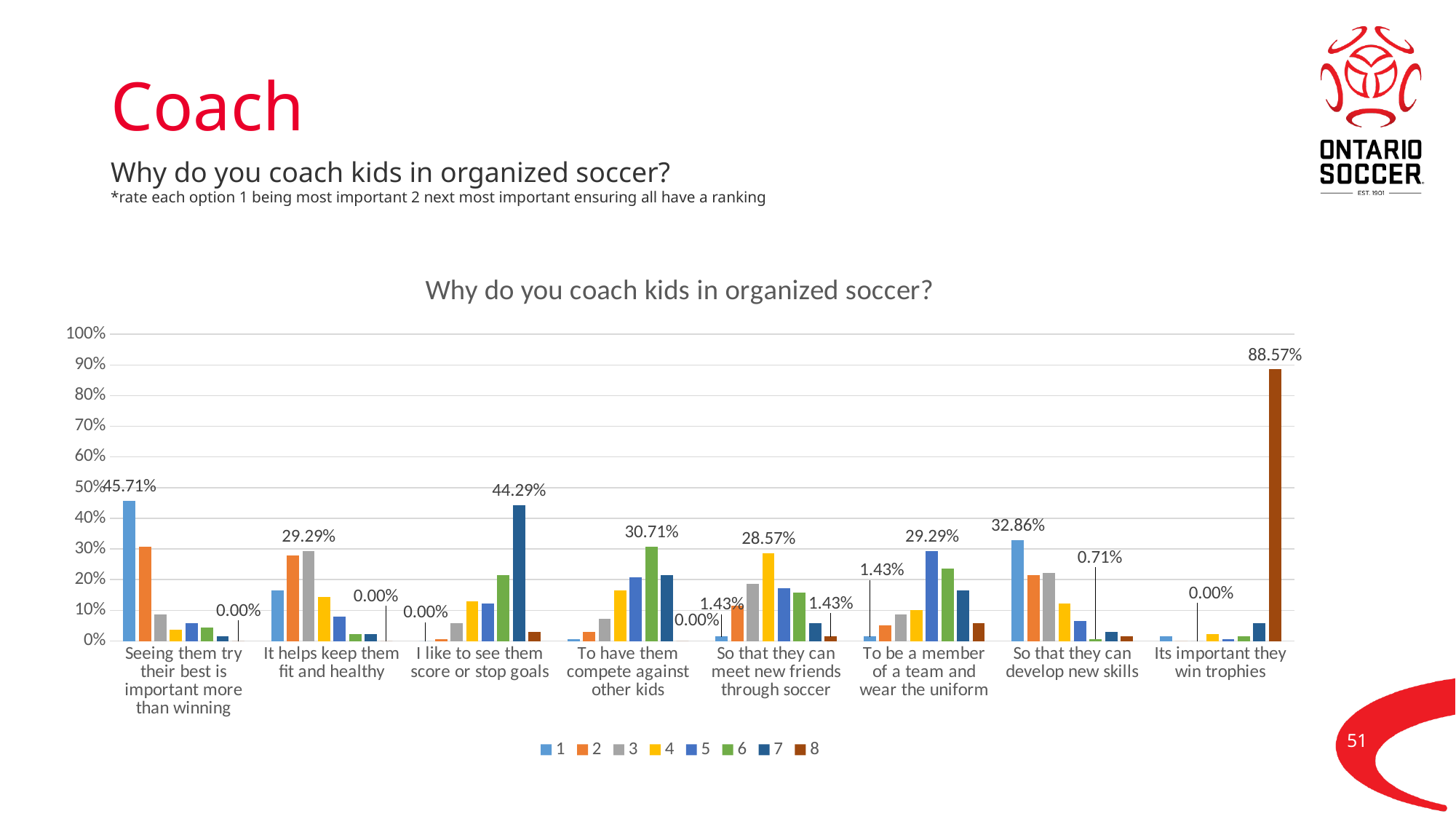
How many series does the legend list? 8 What is the value for series 6 in the category 'To have them compete against other kids'? 30.71% What is the value for series 7 in the category 'I like to see them score or stop goals'? 44.29% What is the difference between the series 8 value for 'Its important they win trophies' and the series 1 value for 'Seeing them try their best is important more than winning'? 42.86% What kind of chart is shown on the slide? bar chart What is the value for series 1 in the category 'Seeing them try their best is important more than winning'? 45.71% What is the value for series 1 in the category 'So that they can develop new skills'? 32.86% Is the value for series 2 in the category 'It helps keep them fit and healthy' greater or less than 20%? greater How many categories are shown along the x axis? 8 What is the value for series 8 in the category 'Its important they win trophies'? 88.57% What is the title of the chart? Why do you coach kids in organized soccer? Which category contains the tallest bar in the chart? Its important they win trophies